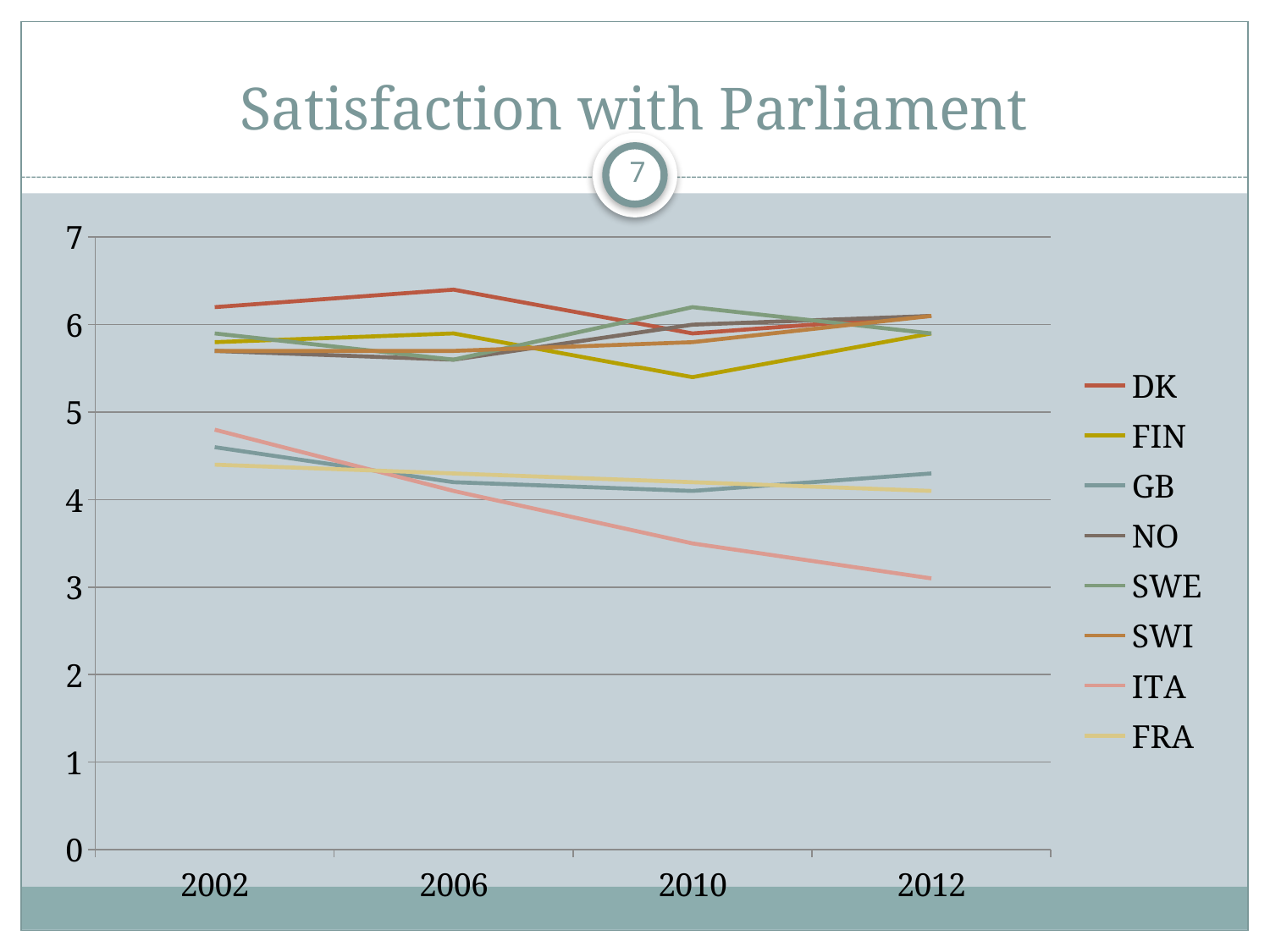
Is the value for ITA in 2012 greater or less than 4? less Which series has the lowest value in 2012? ITA Which series is listed first in the legend? DK What kind of chart is shown on the slide? line chart How many years are shown along the x axis? 4 What is the title of the chart? Satisfaction with Parliament Which series has the highest value in 2006? DK Is the value for DK in 2006 greater or less than 6? greater Is the value for FIN in 2010 greater or less than 5? greater Does the ITA line rise or fall from 2002 to 2012? fall How many series does the legend list? 8